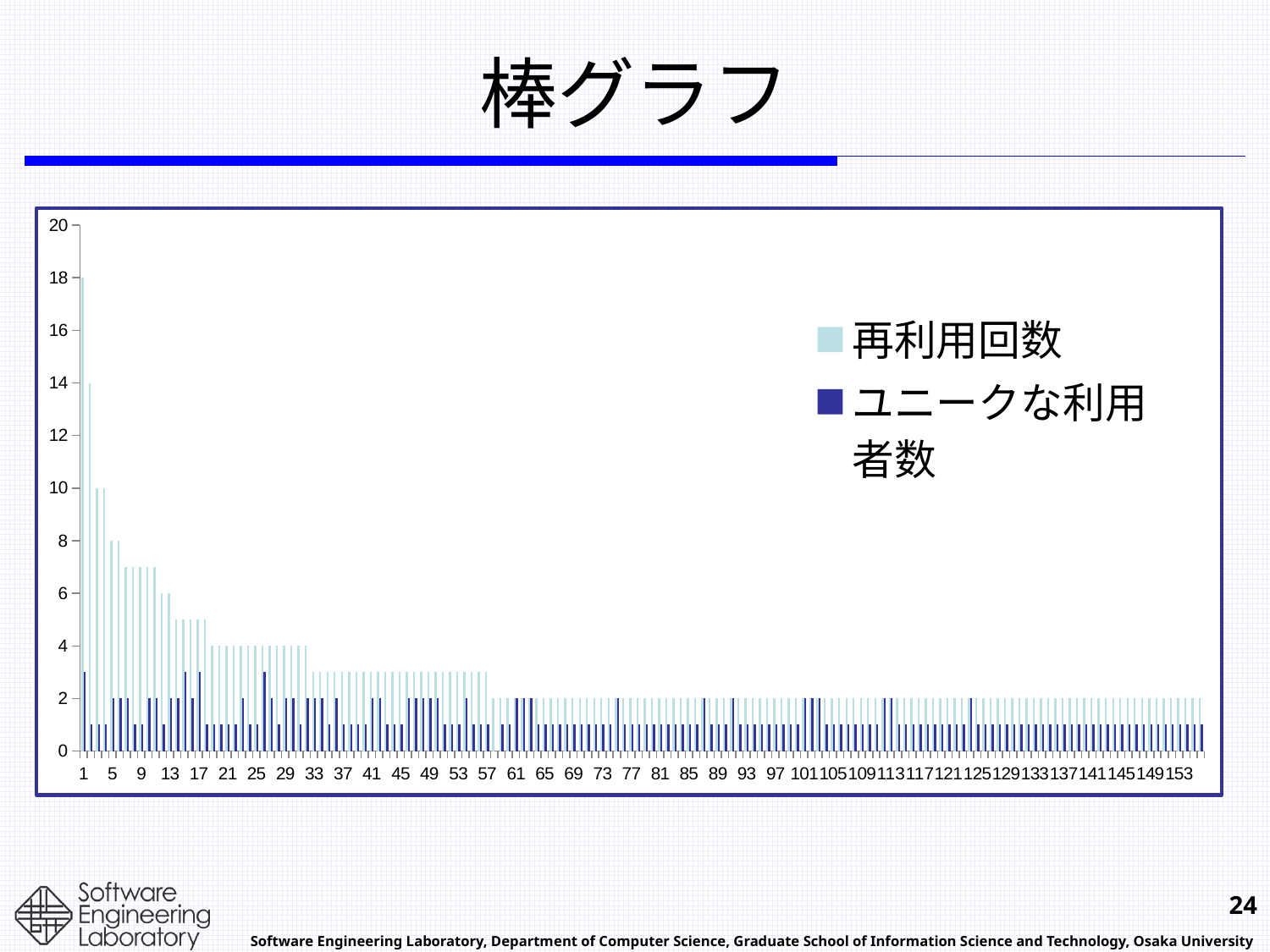
How many series does the chart legend list? 2 Is the 再利用回数 value for category 153 greater or less than 4? less Which category has the highest 再利用回数 value? 1 What are the two series named in the chart legend? 再利用回数 and ユニークな利用者数 What kind of chart is shown on the slide? bar chart What is the 再利用回数 value for category 2? 14 Which is larger, the 再利用回数 value for category 1 or for category 5? category 1 Do the 再利用回数 values rise or fall as you move along the x axis from category 1 to category 153? fall Is the 再利用回数 value for category 1 greater or less than 10? greater What is the 再利用回数 value for category 1? 18 What is the title of the slide containing the chart? 棒グラフ